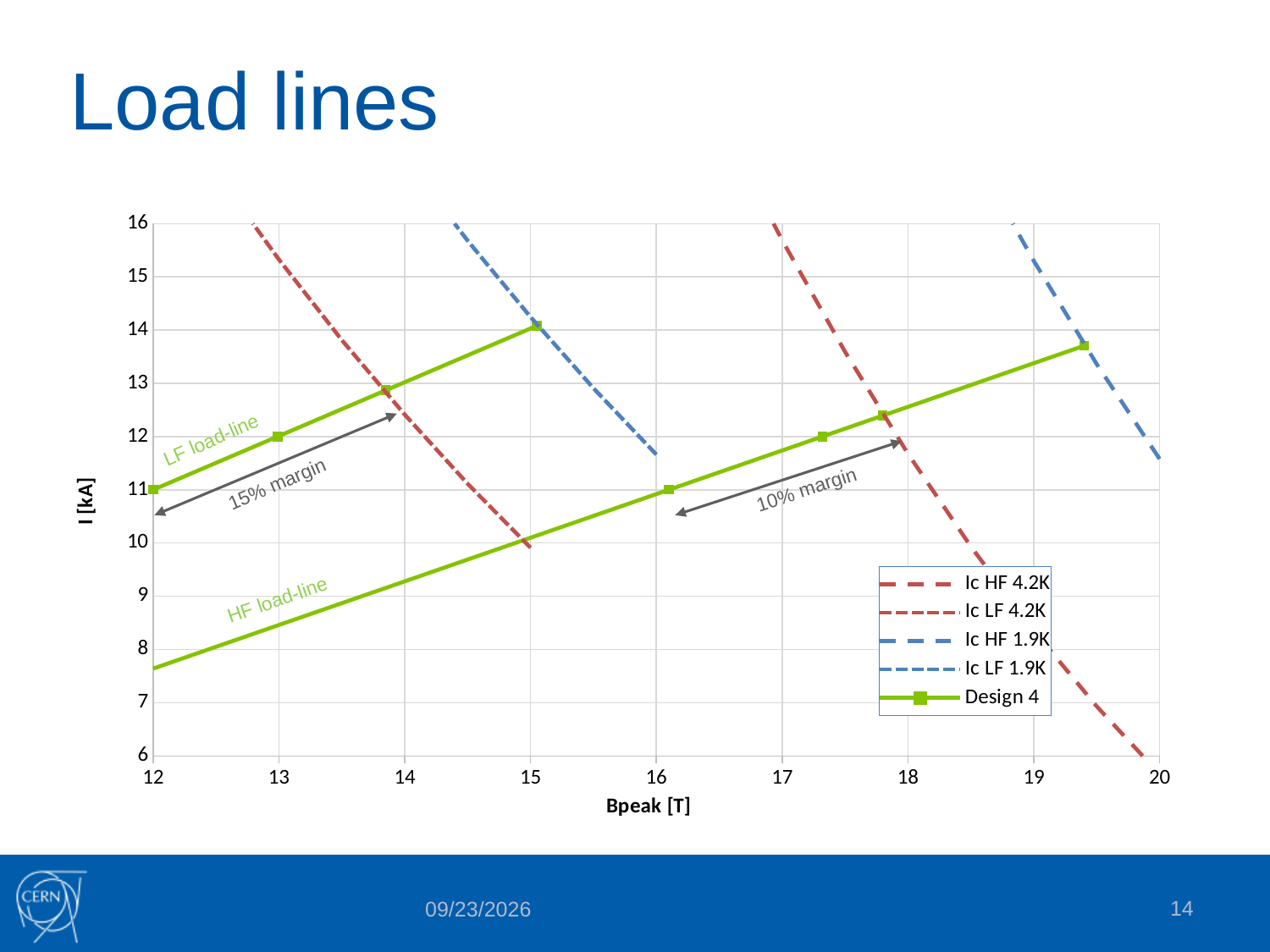
Do the Ic HF 4.2K and Ic LF 4.2K critical current curves rise or fall as Bpeak increases? fall What is the label of the x axis? Bpeak [T] Is the current of the LF load-line at Bpeak = 15 T greater or less than 13 kA? greater Is the current of the HF load-line at Bpeak = 12 T greater or less than 8 kA? less What kind of chart is shown on the slide? line chart How many series does the legend list? 5 What margin is annotated on the HF load-line? 10% margin Which load line reaches a higher current at Bpeak = 15 T, the LF load-line or the HF load-line? LF load-line Is the current of the HF load-line at Bpeak = 16 T greater or less than 10 kA? greater Do the Design 4 load lines rise or fall as Bpeak increases? rise What is the label of the y axis? I [kA]